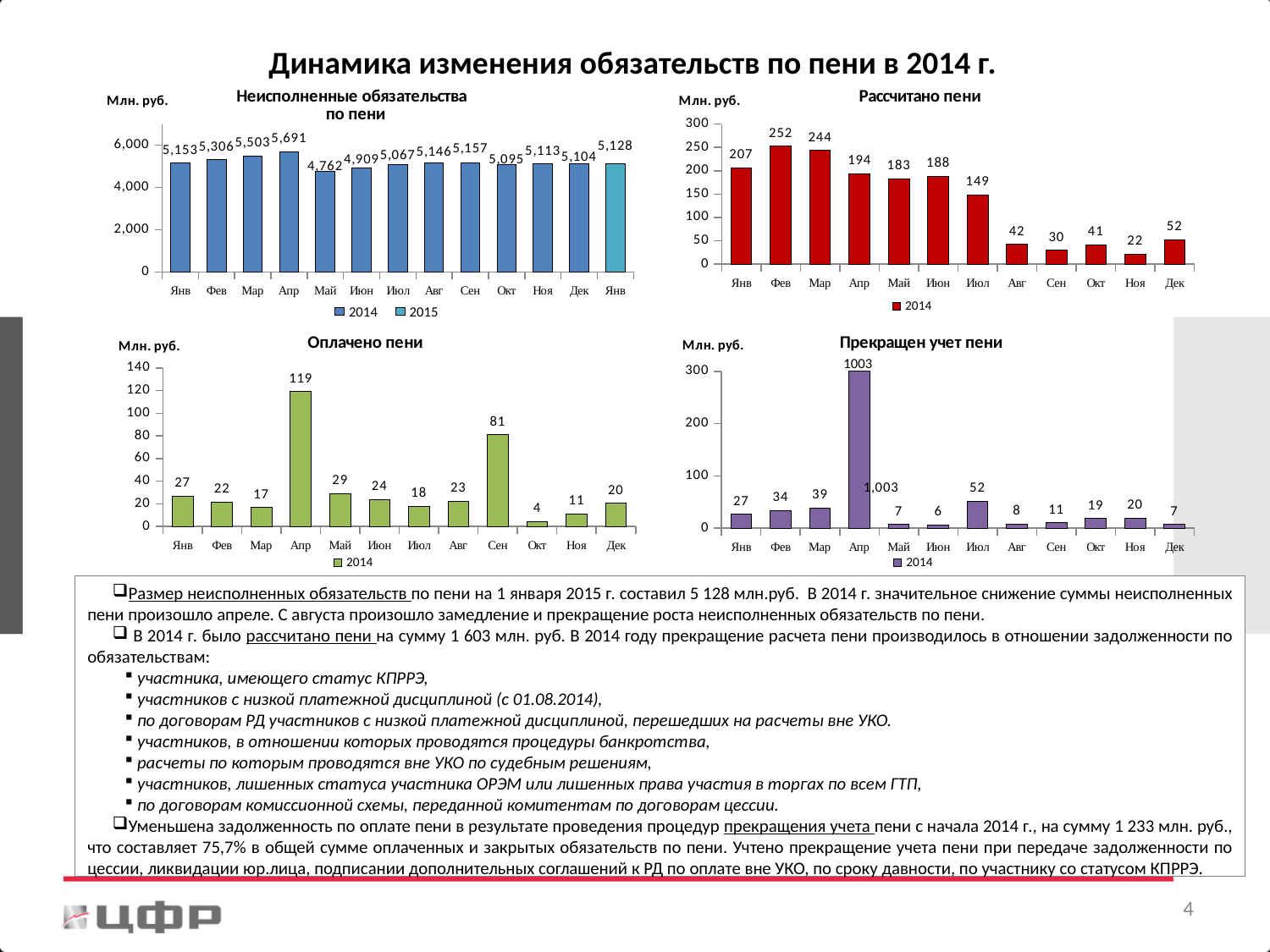
In the chart 'Прекращен учет пени', which is larger, the value for Июл or the value for Мар? Июл In the chart 'Оплачено пени', which month has the lowest value? Окт In the chart 'Неисполненные обязательства по пени', how many series does the legend list? 2 In the chart 'Неисполненные обязательства по пени', what is the value for Май? 4,762 What type of chart is 'Оплачено пени'? Bar chart In the chart 'Рассчитано пени', do the values generally rise or fall from Июн to Ноя? Fall In the chart 'Рассчитано пени', how many months are plotted? 12 In the chart 'Оплачено пени', which month has the highest value? Апр In the chart 'Рассчитано пени', what is the difference between the values for Янв and Дек? 155 In the chart 'Неисполненные обязательства по пени', which month has the highest value? Апр In the chart 'Рассчитано пени', what is the value for Фев? 252 In the chart 'Прекращен учет пени', what is the value for Сен? 11